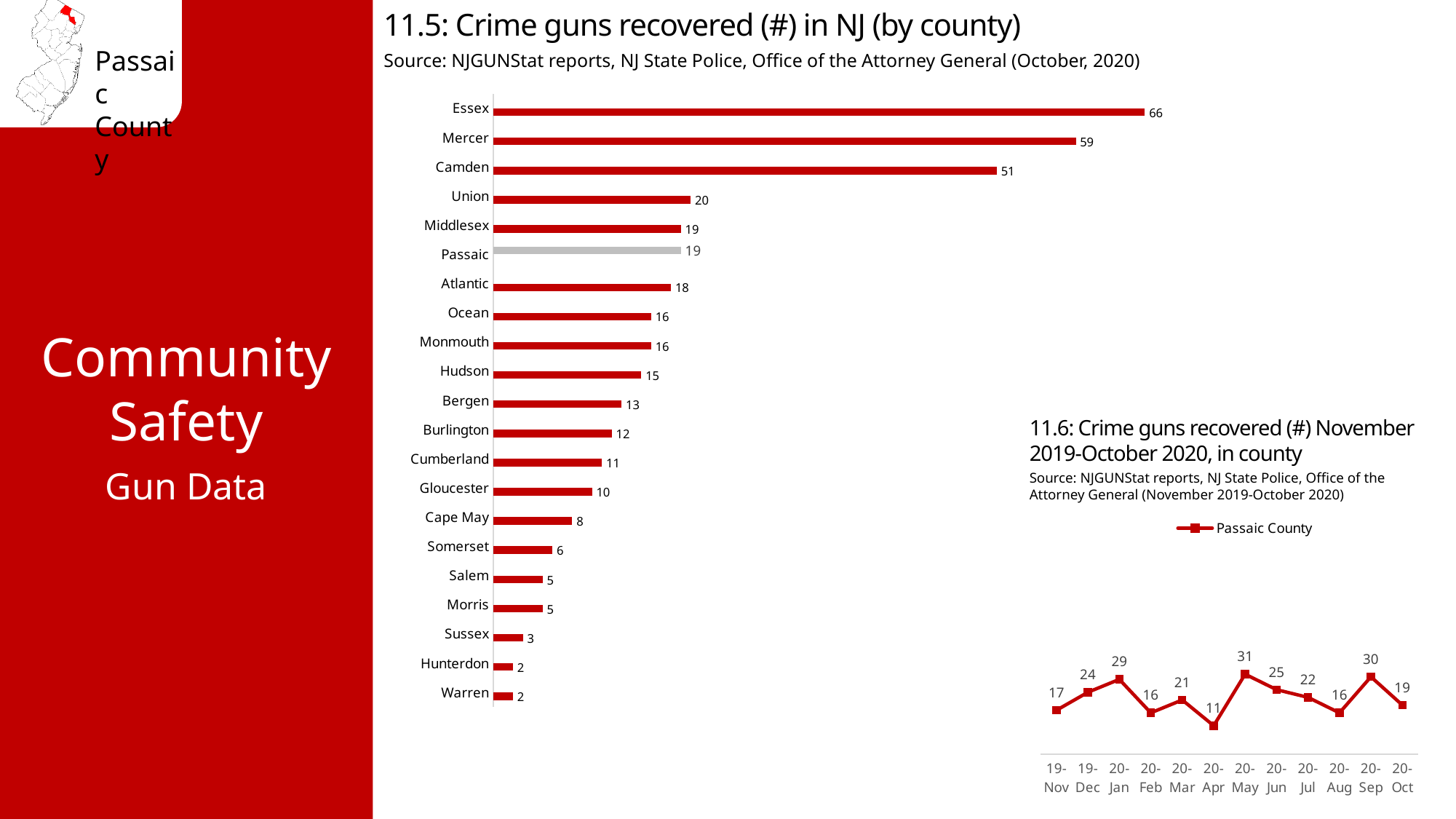
In chart 11.5 (Crime guns recovered in NJ by county), how many crime guns were recovered in Passaic? 19 In chart 11.5 (Crime guns recovered in NJ by county), what is the difference between Essex and Mercer? 7 In chart 11.6 (Crime guns recovered November 2019-October 2020 in county), what is the value for 20-May? 31 In chart 11.6 (Crime guns recovered November 2019-October 2020 in county), what series name does the legend show? Passaic County In chart 11.6 (Crime guns recovered November 2019-October 2020 in county), which month has the lowest value? 20-Apr In chart 11.5 (Crime guns recovered in NJ by county), which is larger, Camden or Union? Camden In chart 11.6 (Crime guns recovered November 2019-October 2020 in county), how many data points are plotted? 12 In chart 11.5 (Crime guns recovered in NJ by county), what kind of chart is it? Bar chart In chart 11.5 (Crime guns recovered in NJ by county), how many counties are shown? 21 In chart 11.5 (Crime guns recovered in NJ by county), what is the value for Gloucester? 10 In chart 11.6 (Crime guns recovered November 2019-October 2020 in county), what is the difference between 20-Sep and 20-Oct? 11 In chart 11.5 (Crime guns recovered in NJ by county), which county has the highest number of crime guns recovered? Essex